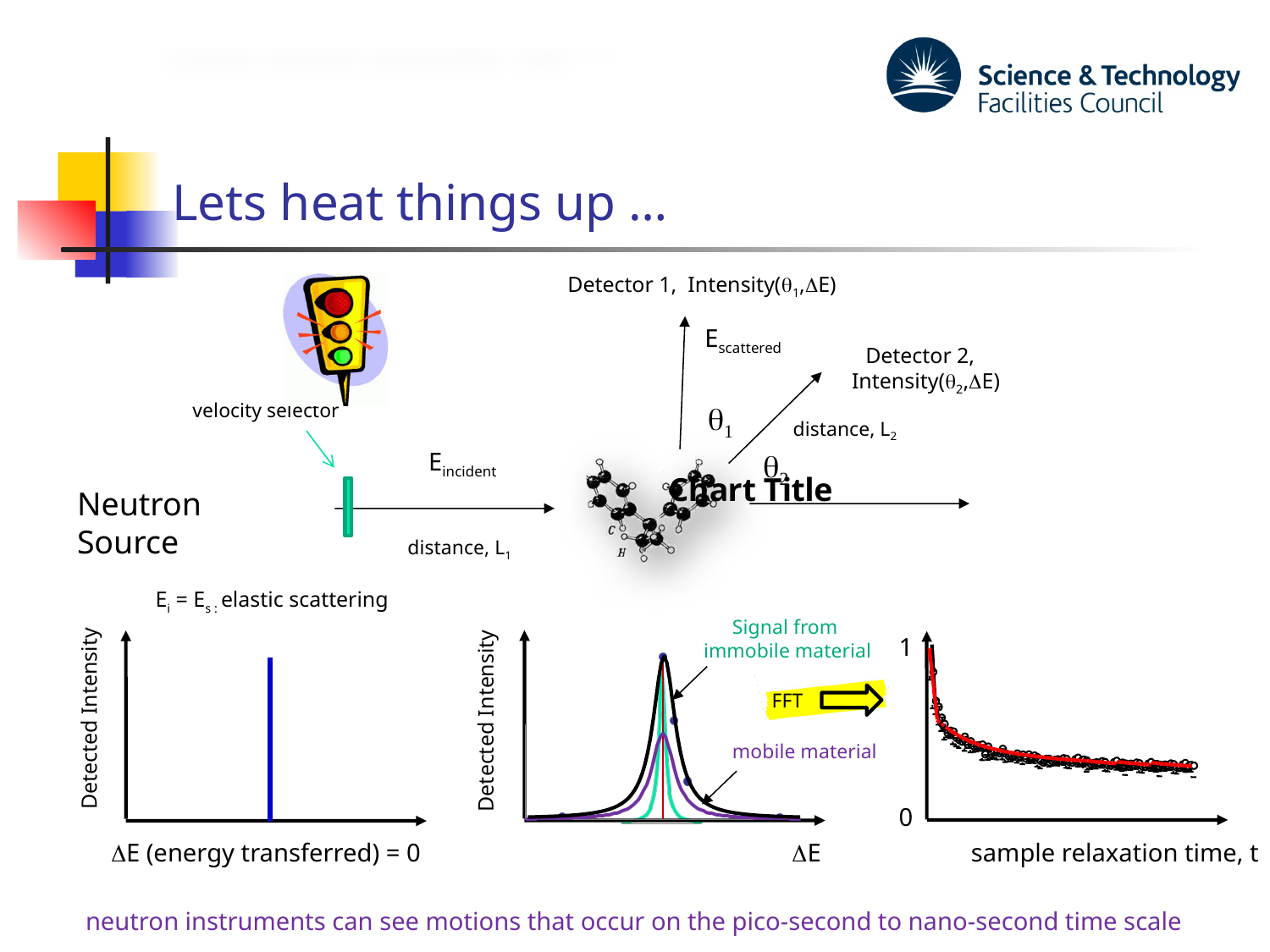
In the right-hand chart (sample relaxation time, t), do the plotted values rise or fall as t increases? fall In the middle chart (Detected Intensity vs ΔE), how many curves are plotted? 3 What is the x-axis label of the left-hand chart? ΔE (energy transferred) = 0 In the right-hand chart (sample relaxation time, t), what is the highest tick value shown on the vertical axis? 1 In the right-hand chart (sample relaxation time, t), is the value at the largest t greater or less than 1? less In the right-hand chart (sample relaxation time, t), what is the lowest tick value shown on the vertical axis? 0 In the right-hand chart (sample relaxation time, t), is the value at the smallest t greater or less than 0? greater In the left-hand chart, how many bars are plotted? 1 What is the x-axis label of the right-hand chart? sample relaxation time, t